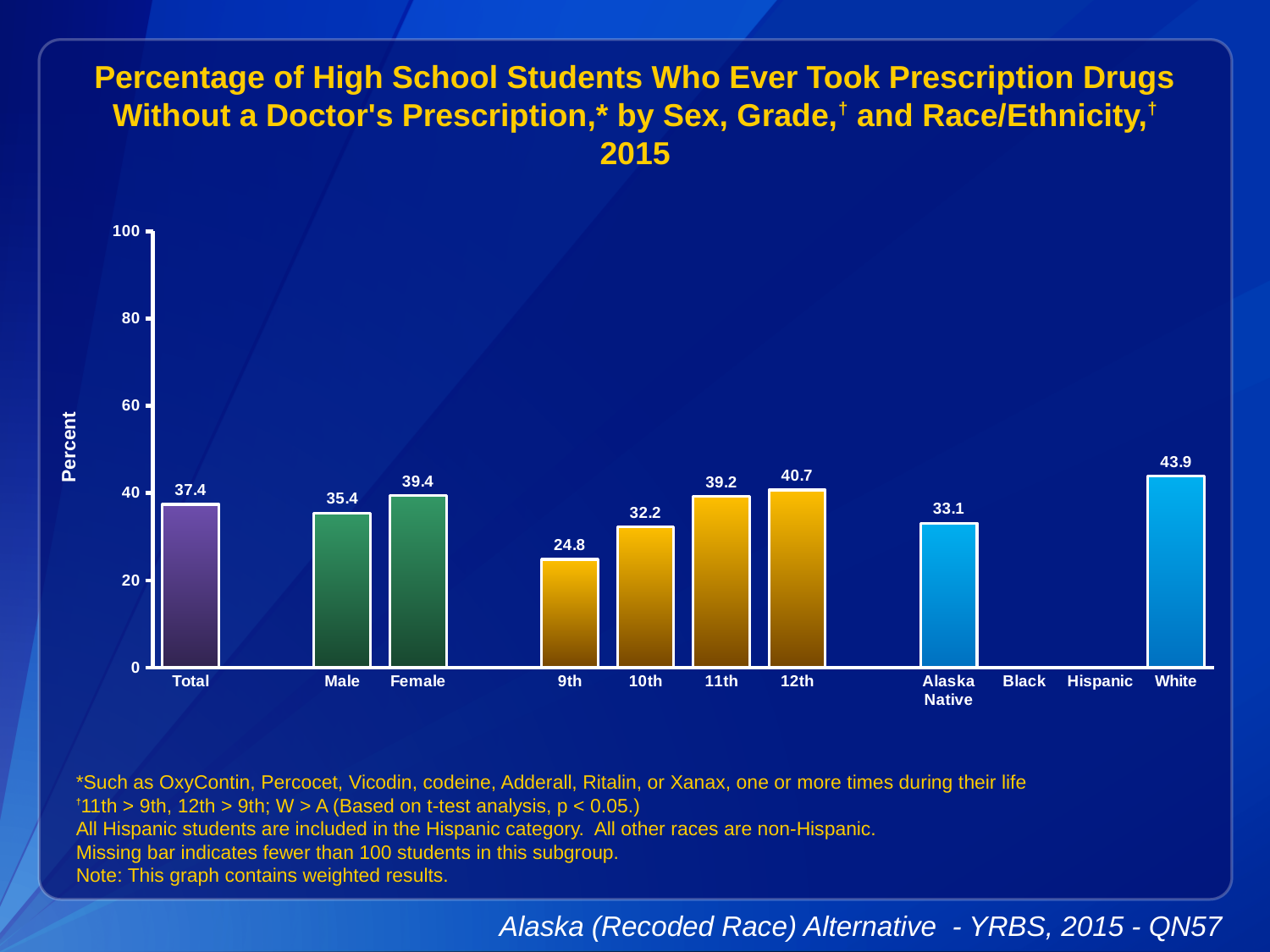
What is the value for 9th grade? 24.8 Which is larger, the value for Male or the value for Female? Female Do the values rise or fall from 9th grade to 12th grade? rise Which category with a bar has the lowest value? 9th What is the value for Alaska Native? 33.1 What is the difference between the values for 12th and 9th grade? 15.9 Is the value for 10th grade greater or less than 40? less Which category has the highest value? White What is the value for Total? 37.4 What is the value for Female? 39.4 What kind of chart is this? bar chart How many categories have a bar plotted? 9